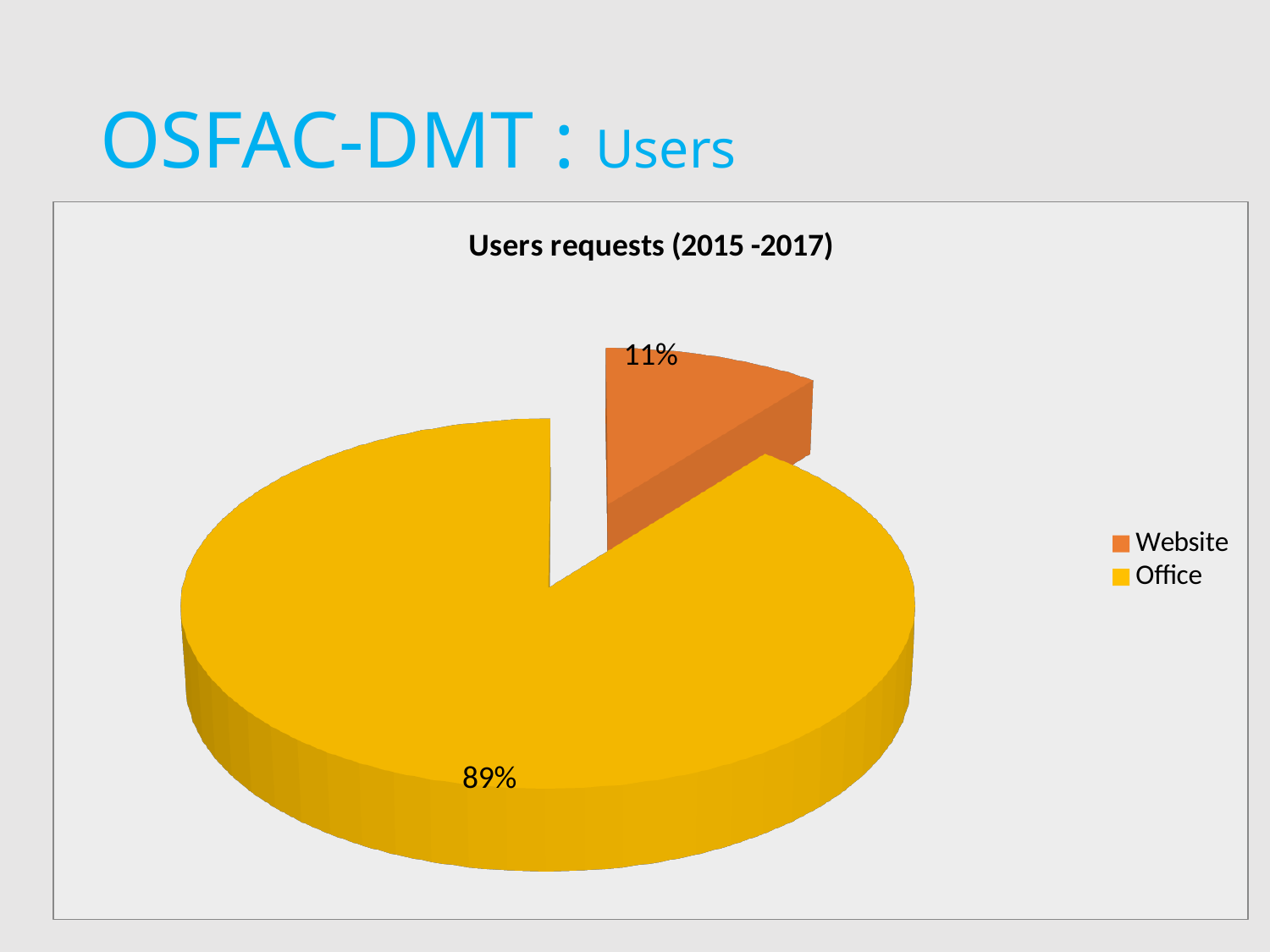
How many entries does the legend list? 2 Which category has the smallest share of user requests? Website What kind of chart is shown on the slide? Pie chart How many categories are shown in the pie chart? 2 Which is larger, the Website share or the Office share? Office What percentage of user requests came from the Website? 11% What is the difference in percentage points between the Office and Website shares? 78 What percentage of user requests came from the Office? 89% What is the title of the chart? Users requests (2015 -2017) What is the share of the pie taken by the Office slice? 89% What colour represents the Website category in the chart? Orange Which category has the largest share of user requests? Office